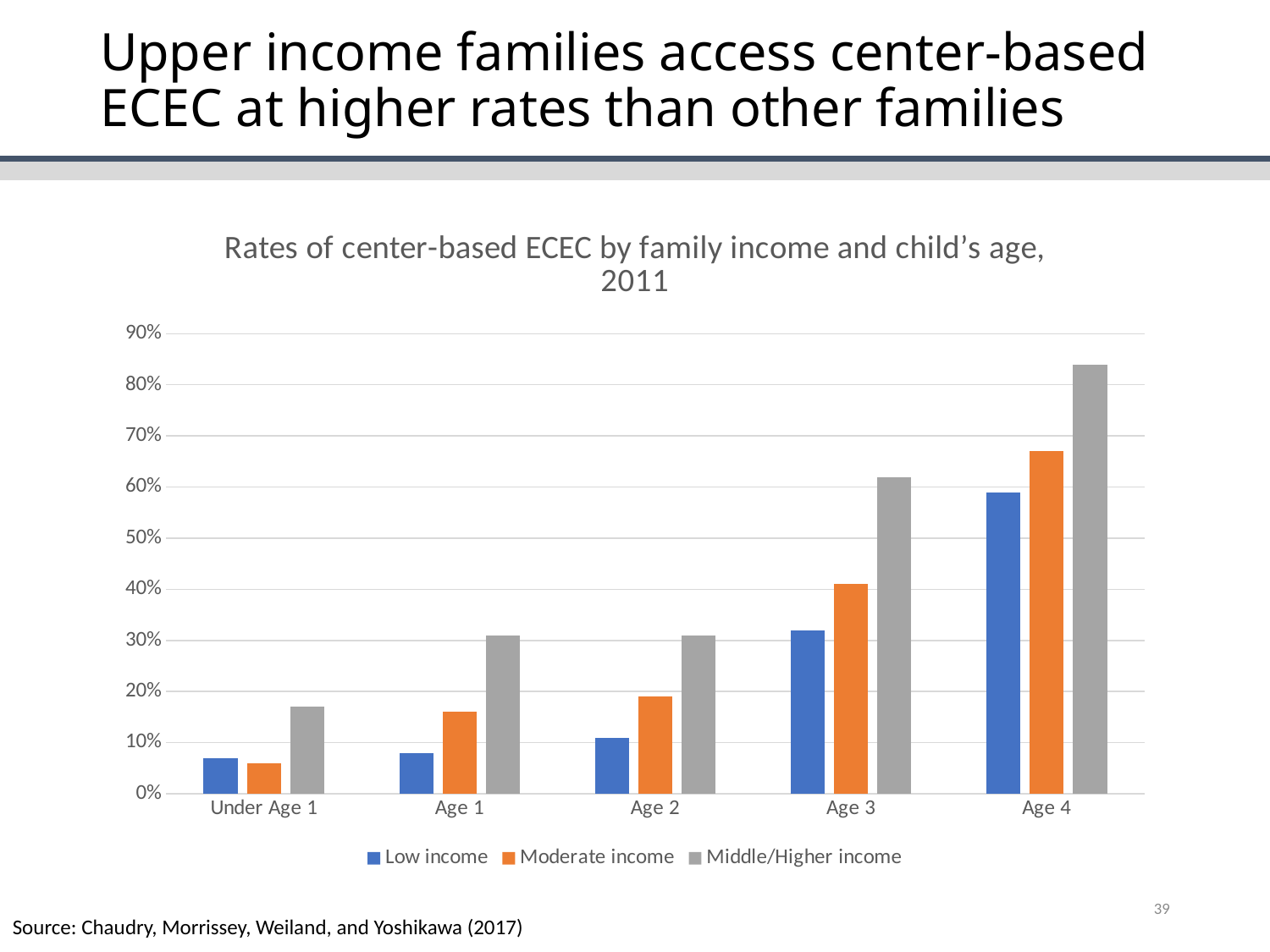
Is the Moderate income value for Age 3 greater or less than 30%? greater Is the Middle/Higher income value for Age 4 greater or less than 80%? greater How many series does the chart's legend list? 3 Which age group has the highest Middle/Higher income rate of center-based ECEC? Age 4 For Age 3, which is larger: the Low income value or the Moderate income value? Moderate income How many age groups are shown on the x axis of the chart? 5 Which age group has the lowest Middle/Higher income rate of center-based ECEC? Under Age 1 Which age group has the highest Low income rate of center-based ECEC? Age 4 Is the Low income value for Age 4 greater or less than 50%? greater What kind of chart is shown on the slide? Bar chart Does the Middle/Higher income rate rise or fall as the child's age increases from Under Age 1 to Age 4? Rises